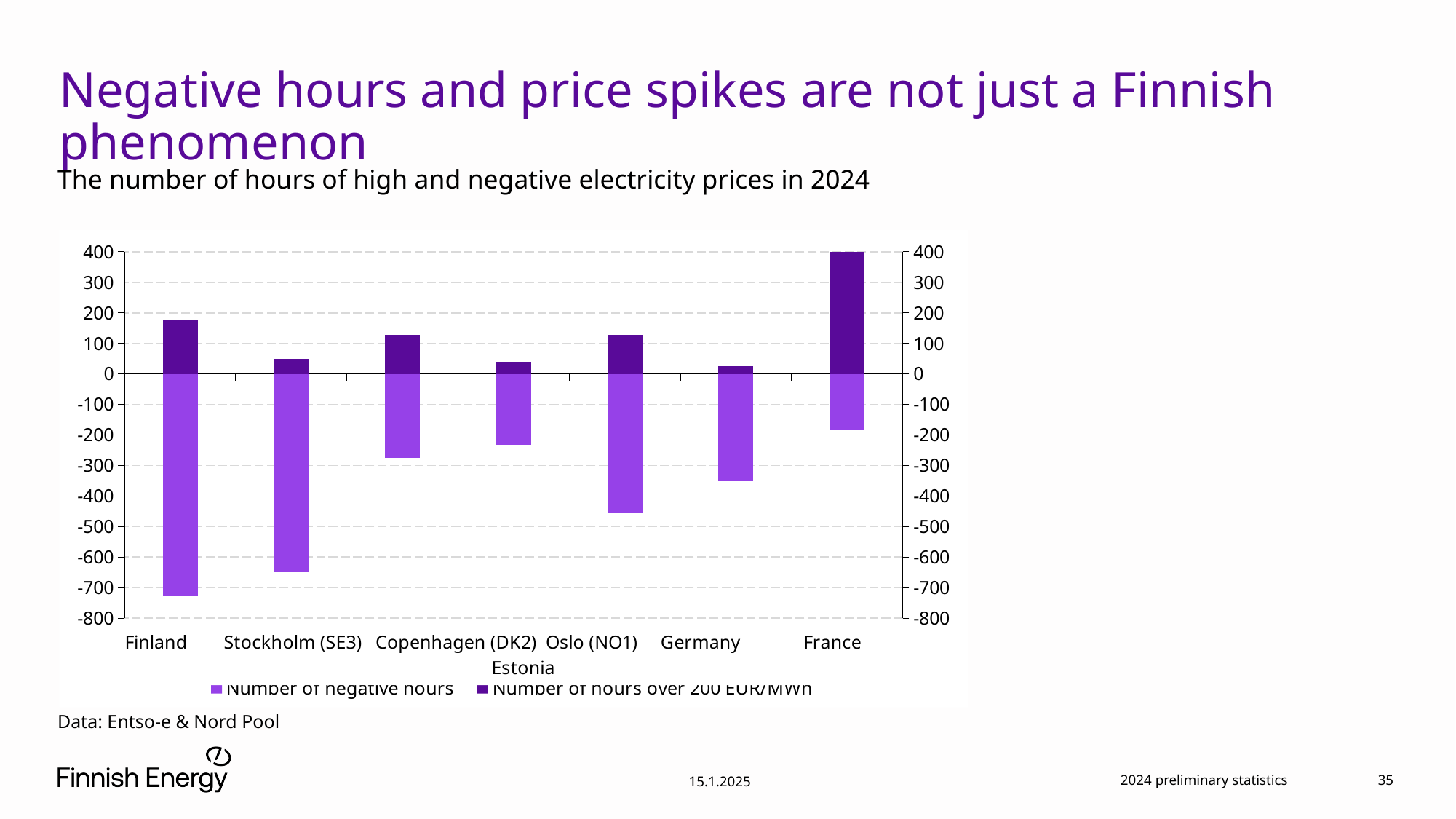
What is the subtitle describing the chart's data? The number of hours of high and negative electricity prices in 2024 Which country or price area has the largest number of negative hours (the longest bar below zero)? Finland Which country or price area has the highest number of hours over 200 EUR/MWh? Estonia How many series does the chart's legend list? 2 Which has the longer negative-hours bar, Oslo (NO1) or Germany? Germany Is the number of hours over 200 EUR/MWh for France greater or less than 300? less How many countries or price areas are shown on the x axis of the chart? 7 Is the negative-hours value for Germany greater or less than -300 on the axis? less Is the negative-hours value for Finland greater or less than -700 on the axis? less Which country or price area has the lowest number of hours over 200 EUR/MWh? France Which country or price area has the fewest negative hours (the shortest bar below zero)? Estonia What kind of chart is shown on the slide? bar chart